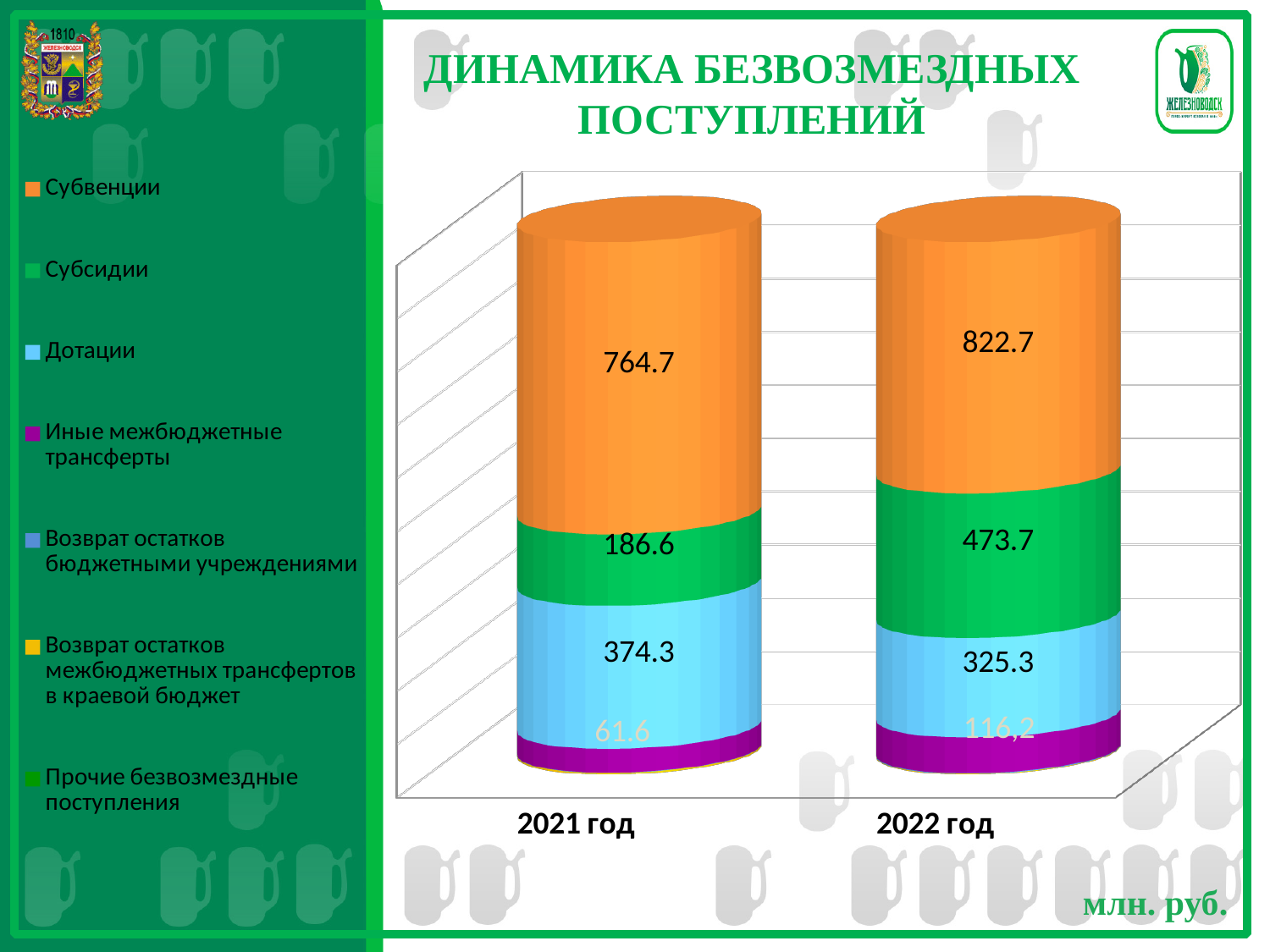
How many categories (years) are shown on the x axis? 2 How many series does the legend list? 7 What kind of chart is shown on the slide? Stacked bar chart What is the value for Субвенции in 2021 год? 764.7 Which series has the highest value in 2022 год? Субвенции What is the difference between the Субвенции values for 2022 год and 2021 год? 58.0 What is the difference between the Субсидии values for 2022 год and 2021 год? 287.1 Which is larger: Дотации in 2021 год or Дотации in 2022 год? 2021 год What is the value for Иные межбюджетные трансферты in 2022 год? 116,2 What is the value for Дотации in 2021 год? 374.3 What is the value for Субсидии in 2022 год? 473.7 Which labelled series has the lowest value in 2021 год? Иные межбюджетные трансферты